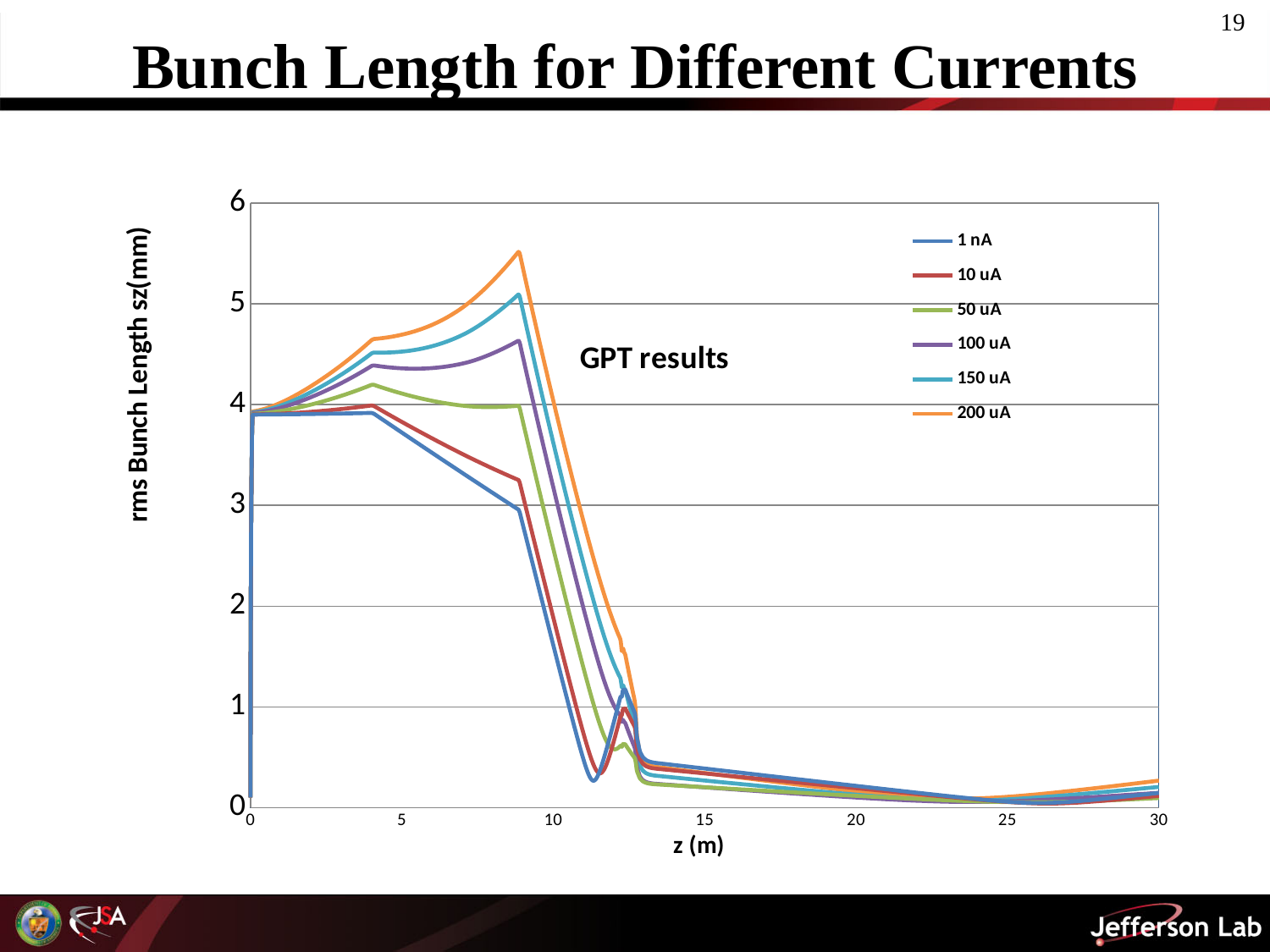
Between z = 0 m and z = 9 m, does the 200 uA series rise or fall? rise What is the label of the x axis? z (m) What is the title of the chart on the slide? GPT results Is the value of the 1 nA series at z = 20 m greater or less than 1? less Is the peak value of the 200 uA series greater or less than 5? greater How many series does the legend list? 6 Between z = 10 m and z = 12 m, do the values of the series rise or fall? fall What kind of chart is shown on the slide? line chart Which series has the larger value at z = 8 m, 150 uA or 50 uA? 150 uA Which series has the lowest value at around z = 9 m, just before the steep drop? 1 nA Which series reaches the highest peak value of rms bunch length? 200 uA Is the peak value of the 100 uA series greater or less than 5? less